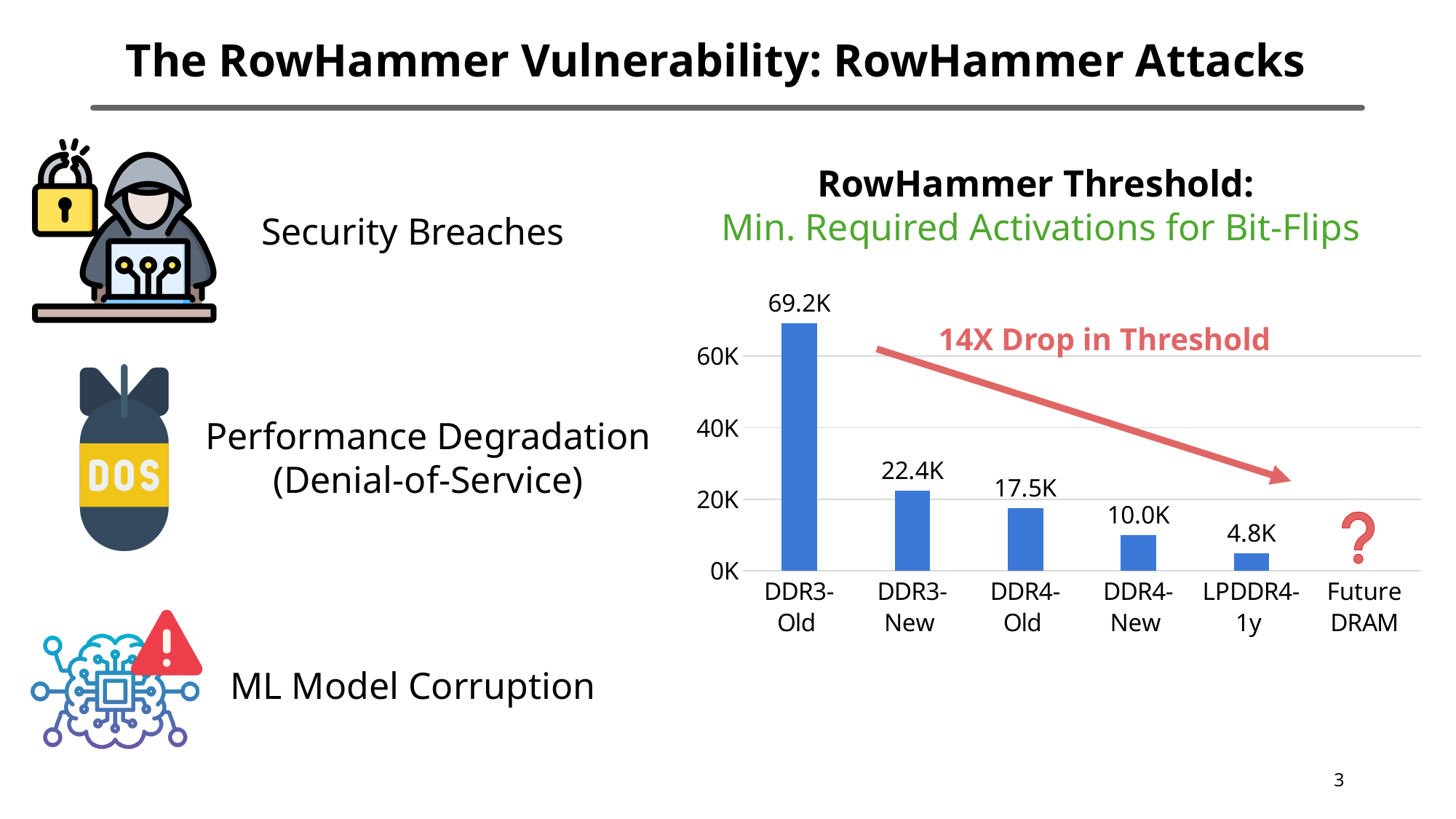
What is the difference between the values for DDR3-Old and DDR3-New? 46.8K Is the value for DDR4-New greater or less than 20K? less Which has a larger value, DDR3-New or DDR4-Old? DDR3-New How many bars are plotted in the chart? 5 Which category with a plotted bar has the lowest RowHammer threshold? LPDDR4-1y What is the difference between the values for DDR4-New and LPDDR4-1y? 5.2K What value is labeled on the bar for DDR4-Old? 17.5K What kind of chart is shown on the slide? bar chart Which category has the highest RowHammer threshold in the chart? DDR3-Old What is the RowHammer threshold value shown for DDR3-Old? 69.2K Do the values rise or fall from DDR3-Old to LPDDR4-1y along the x axis? fall What value is labeled on the bar for LPDDR4-1y? 4.8K